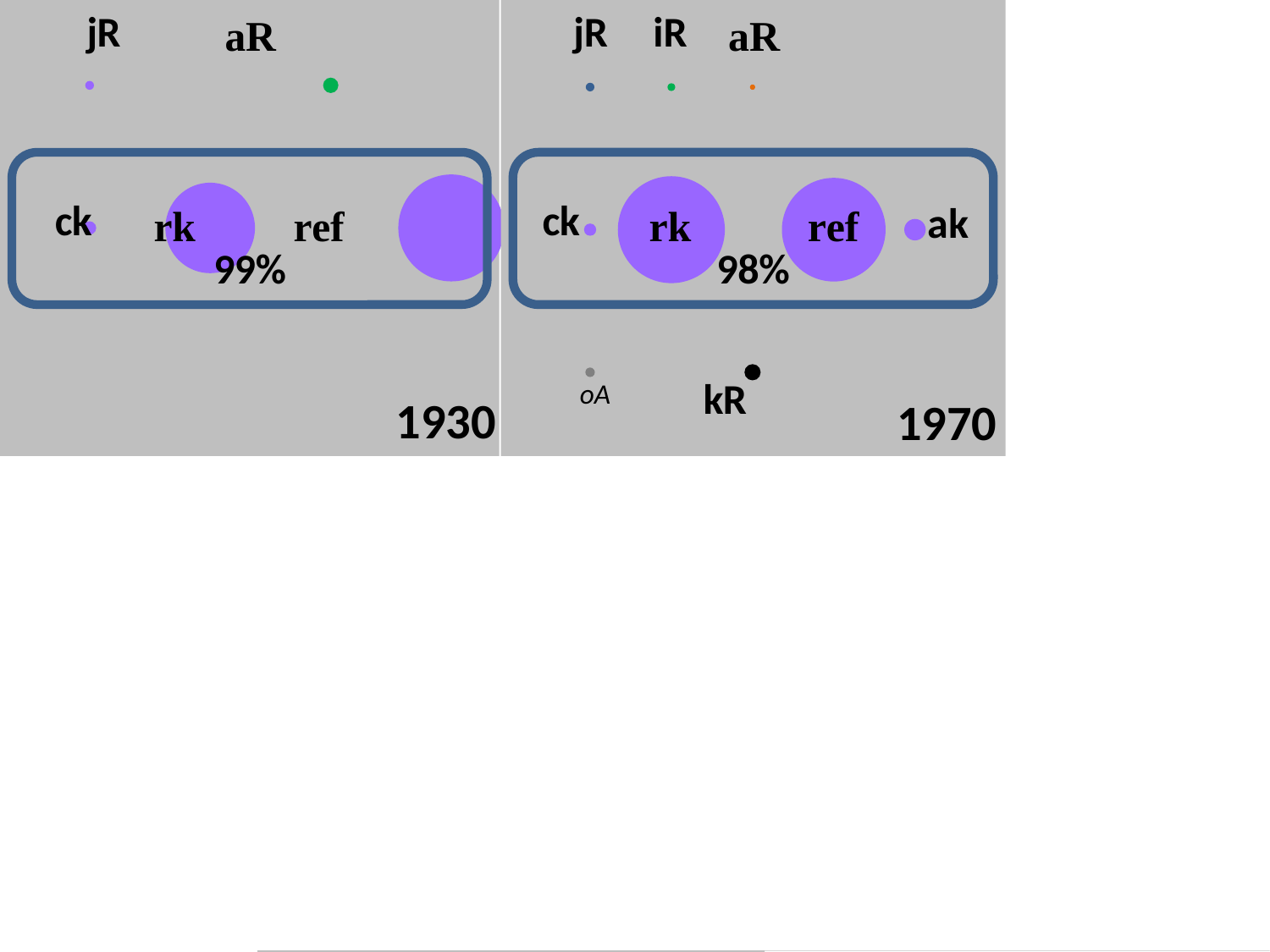
What percentage is printed inside the outlined box in the 1930 panel? 99% In the 1970 panel, what colour is the kR bubble? black In the 1930 panel, which bubble is larger, rk or jR? rk What is the difference between the percentage shown in the 1930 panel and the percentage shown in the 1970 panel? 1% How many labelled bubbles are in the 1930 panel? 5 Which two years label the two panels? 1930 and 1970 In the 1970 panel, which bubble is larger, rk or ck? rk How many labelled bubbles are in the 1970 panel? 9 What percentage is printed inside the outlined box in the 1970 panel? 98% In the 1970 panel, which bubble is larger, ref or ak? ref What kind of chart is shown in each panel? bubble chart